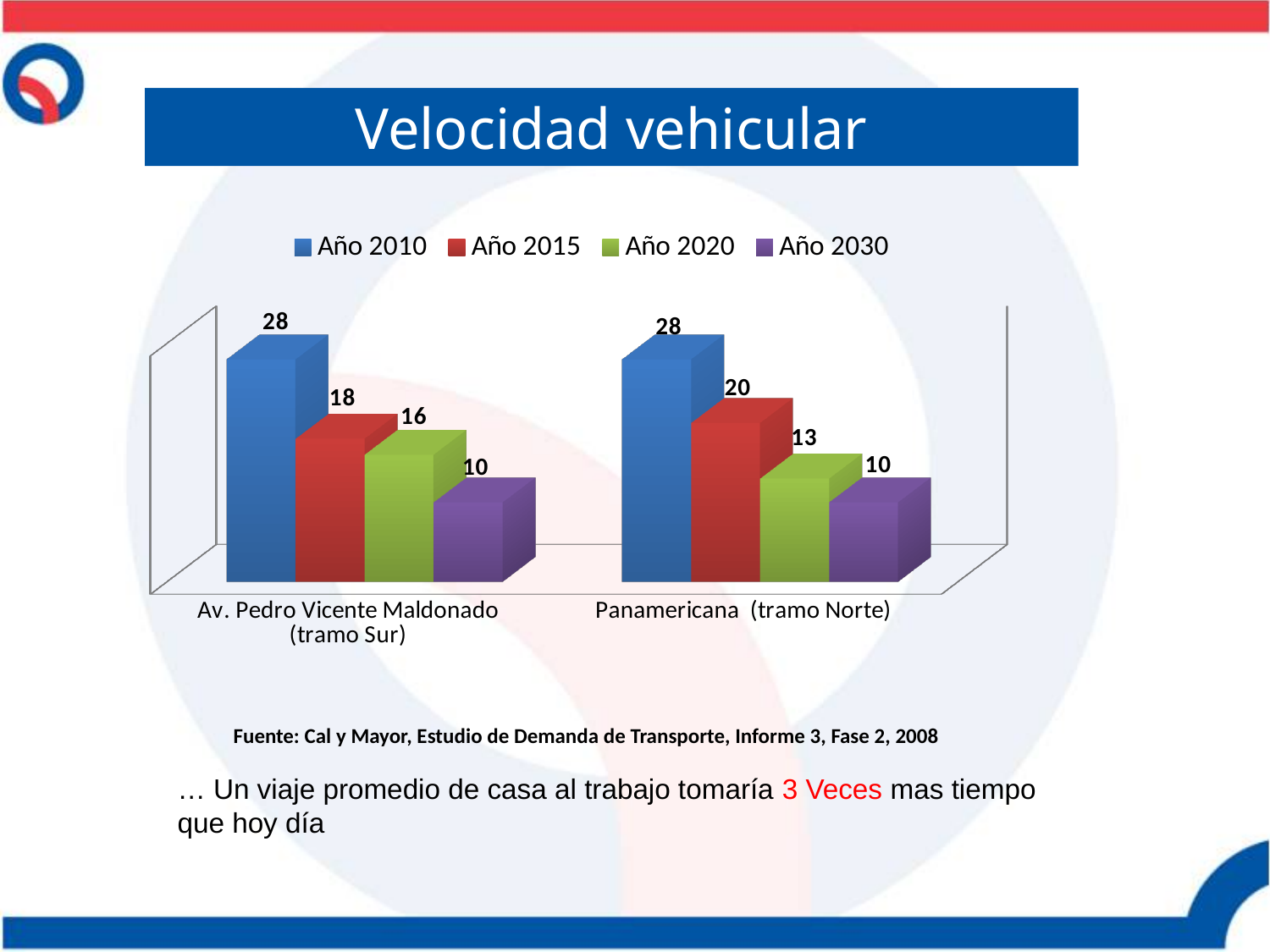
What is the difference between the Año 2010 and Año 2030 values for Panamericana (tramo Norte)? 18 What is the value for Año 2030 for Av. Pedro Vicente Maldonado (tramo Sur)? 10 What is the value for Año 2015 for Av. Pedro Vicente Maldonado (tramo Sur)? 18 Which year series has the highest value for Panamericana (tramo Norte)? Año 2010 How many series does the legend list? 4 What is the value for Año 2020 for Panamericana (tramo Norte)? 13 What is the difference between the Año 2015 values for Panamericana (tramo Norte) and Av. Pedro Vicente Maldonado (tramo Sur)? 2 What kind of chart is shown on the slide? Bar chart Do the values for Panamericana (tramo Norte) rise or fall from Año 2010 to Año 2030? Fall Which is larger: the Año 2020 value for Av. Pedro Vicente Maldonado (tramo Sur) or for Panamericana (tramo Norte)? Av. Pedro Vicente Maldonado (tramo Sur) Which year series has the lowest value for Av. Pedro Vicente Maldonado (tramo Sur)? Año 2030 What is the value for Año 2010 for Panamericana (tramo Norte)? 28